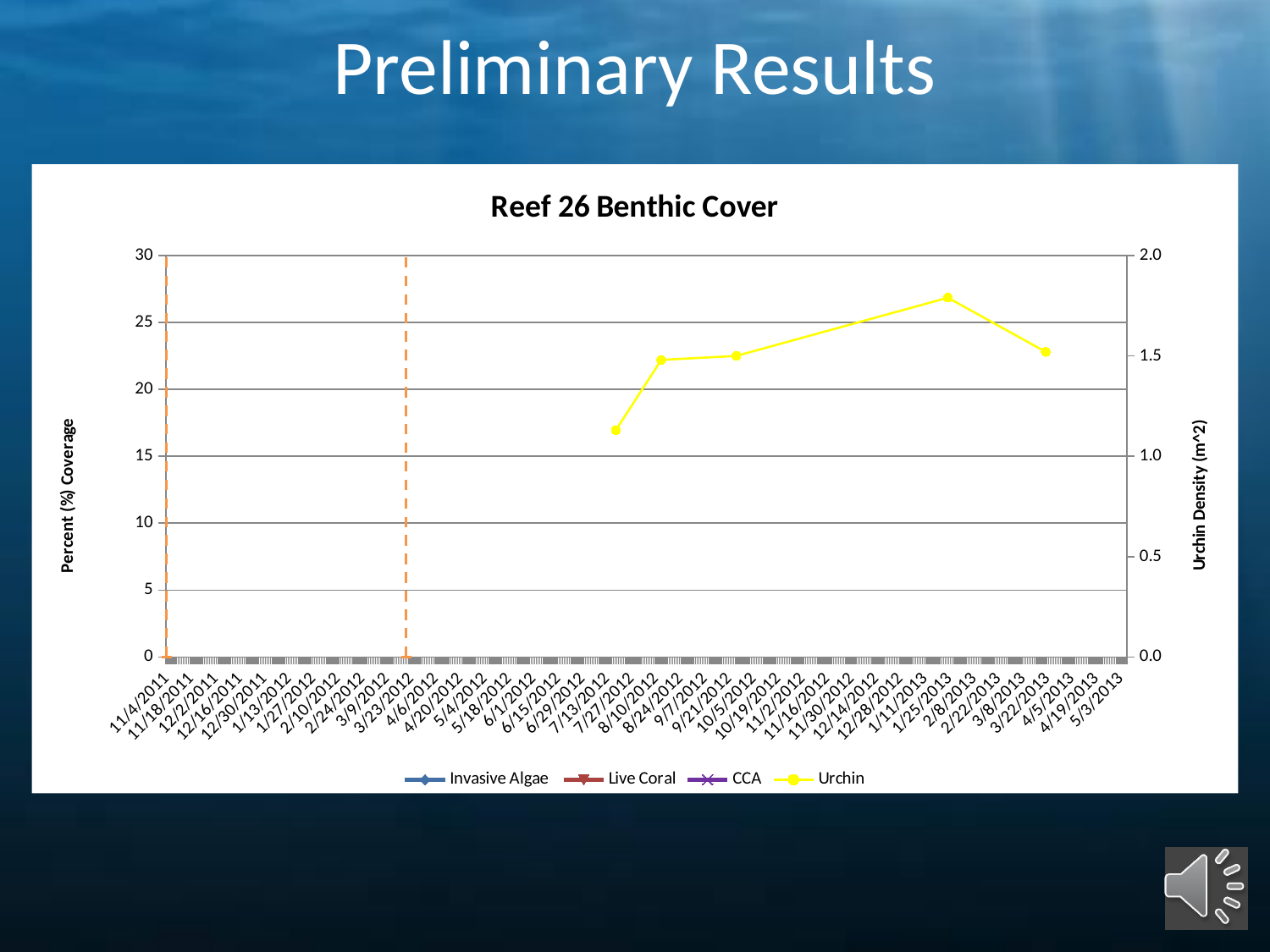
At which date does the Urchin series reach its highest value? 1/25/2013 Which series are listed in the legend? Invasive Algae, Live Coral, CCA, Urchin How many data points are plotted for the Urchin series? 5 How many series does the legend list? 4 Which is larger for the Urchin series: the value at 7/13/2012 or the value at 1/25/2013? 1/25/2013 What kind of chart is shown on the slide? line chart Is the first plotted Urchin value (at 7/13/2012) greater or less than 1.5 on the Urchin Density axis? less Does the Urchin series rise or fall between its fourth point (1/25/2013) and its last point (3/22/2013)? fall At which date does the Urchin series have its lowest value? 7/13/2012 Is the first plotted Urchin value (at 7/13/2012) greater or less than 1.0 on the Urchin Density axis? greater Is the highest Urchin value greater or less than 1.5 on the Urchin Density axis? greater What is the title of the chart? Reef 26 Benthic Cover